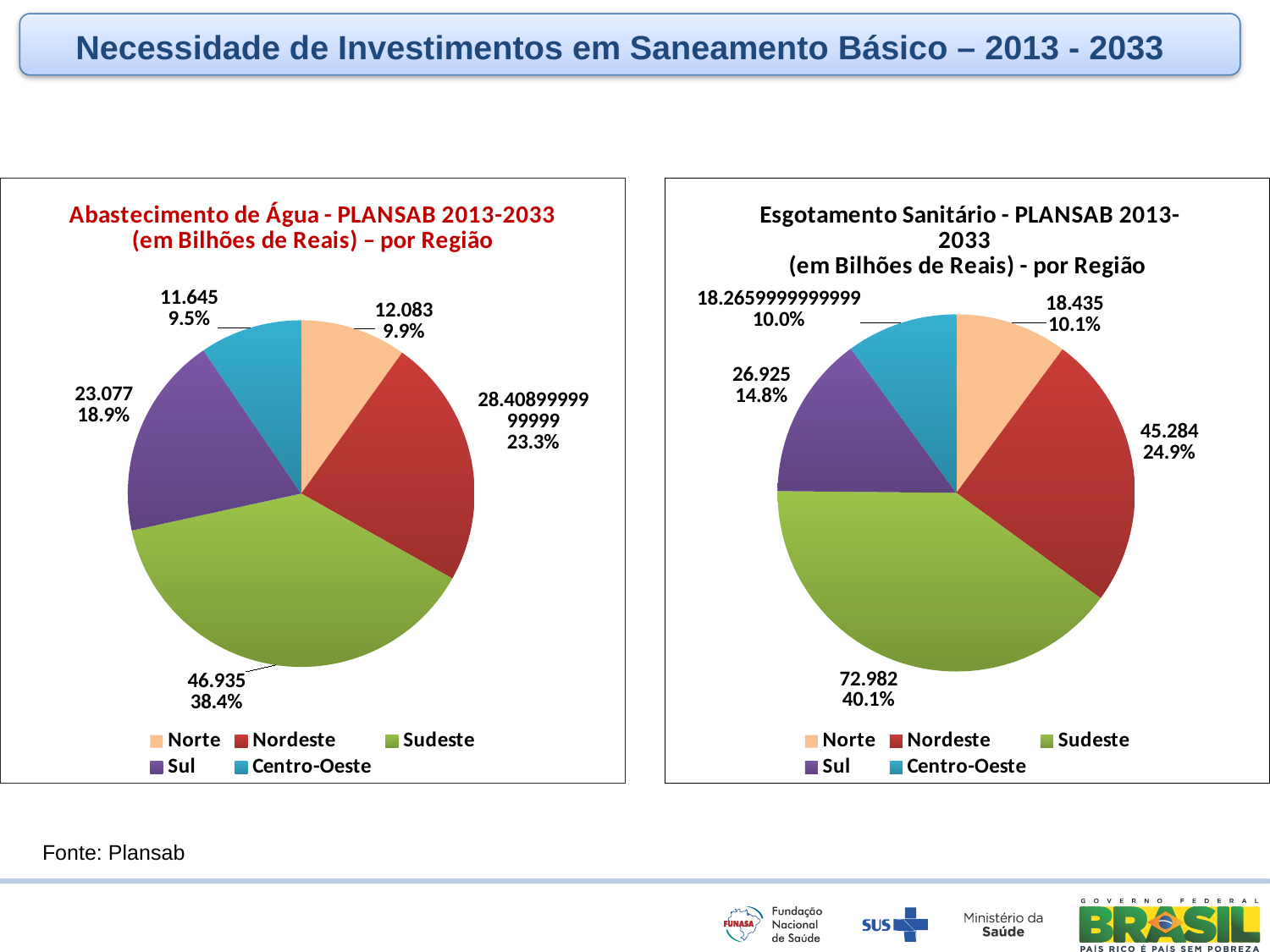
In the Esgotamento Sanitário chart, which is larger, the value for Sul or the value for Norte? Sul In the Esgotamento Sanitário chart, what share of the pie does Sudeste represent? 40.1% In the Esgotamento Sanitário chart, what value is shown for Nordeste? 45.284 In the Abastecimento de Água chart, what is the difference between the values for Sul and Norte? 10.994 In the Abastecimento de Água chart, what value is shown for Sudeste? 46.935 In the Esgotamento Sanitário chart, which region has the largest slice? Sudeste How many regions are shown in the Esgotamento Sanitário chart? 5 What type of chart is the Abastecimento de Água chart? Pie chart In the Abastecimento de Água chart, which region has the largest slice? Sudeste In the Abastecimento de Água chart, what share of the pie does Sul represent? 18.9% In the Abastecimento de Água chart, which region has the smallest slice? Centro-Oeste In the Esgotamento Sanitário chart, what is the difference between the values for Sudeste and Nordeste? 27.698